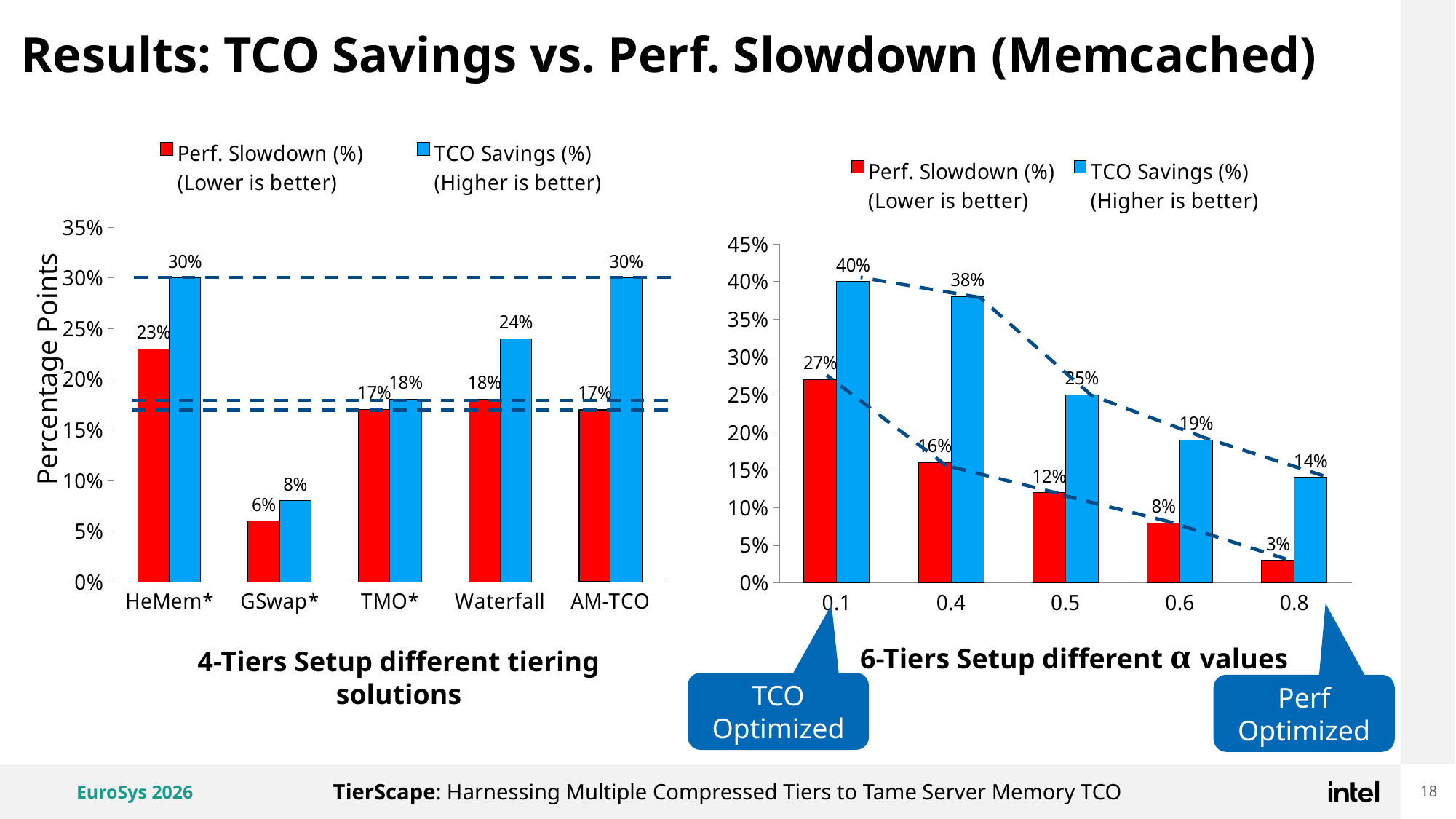
In the left chart (4-Tiers Setup different tiering solutions), which tiering solution has the lowest Perf. Slowdown (%)? GSwap* In the left chart (4-Tiers Setup different tiering solutions), how many tiering solutions are shown on the x axis? 5 In the right chart (6-Tiers Setup different α values), which is larger: the Perf. Slowdown (%) at α = 0.4 or the Perf. Slowdown (%) at α = 0.6? α = 0.4 In the right chart (6-Tiers Setup different α values), how does the Perf. Slowdown (%) change as α increases from 0.1 to 0.8? It falls In the left chart (4-Tiers Setup different tiering solutions), what is the TCO Savings (%) value for Waterfall? 24% In the right chart (6-Tiers Setup different α values), what is the difference in TCO Savings (%) between α = 0.1 and α = 0.4? 2% In the right chart (6-Tiers Setup different α values), what is the TCO Savings (%) value at α = 0.5? 25% In the left chart (4-Tiers Setup different tiering solutions), what is the Perf. Slowdown (%) value for HeMem*? 23% How many series does the legend of the left chart (4-Tiers Setup different tiering solutions) list? 2 In the left chart (4-Tiers Setup different tiering solutions), what is the difference between the TCO Savings (%) and Perf. Slowdown (%) for AM-TCO? 13% In the right chart (6-Tiers Setup different α values), what is the Perf. Slowdown (%) value at α = 0.8? 3% In the right chart (6-Tiers Setup different α values), which α value has the highest TCO Savings (%)? 0.1